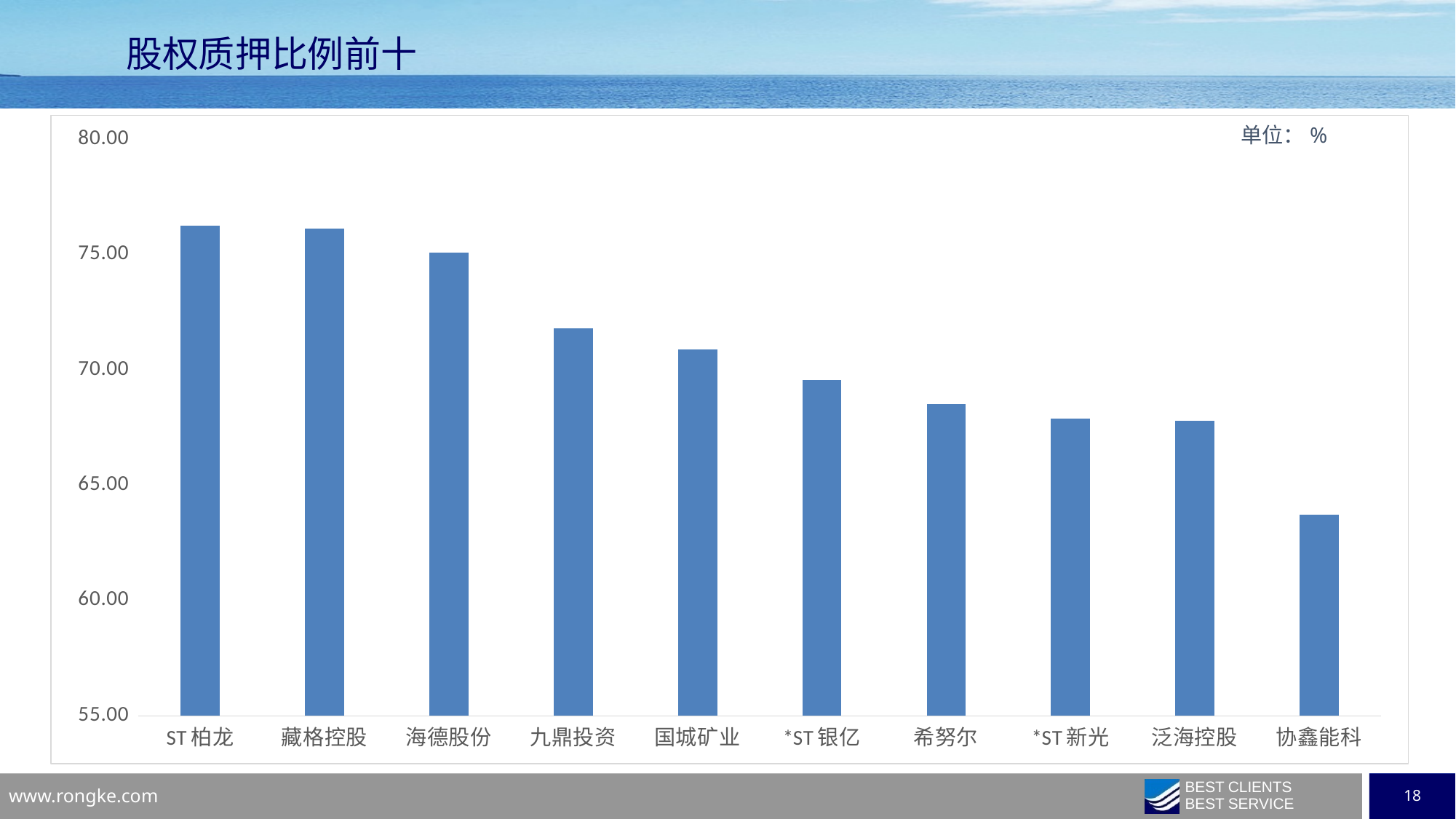
Which company has the lowest value in the chart? 协鑫能科 How many companies are shown on the x axis of the chart? 10 Is the value for 希努尔 greater or less than 70? less Do the values rise or fall from left to right along the x axis? fall Which is larger, the value for 国城矿业 or the value for 协鑫能科? 国城矿业 Which is larger, the value for 海德股份 or the value for 九鼎投资? 海德股份 Is the value for 九鼎投资 greater or less than 70? greater What unit is indicated for the values in the chart? % Is the value for *ST银亿 greater or less than 70? less What kind of chart is shown on the slide? bar chart